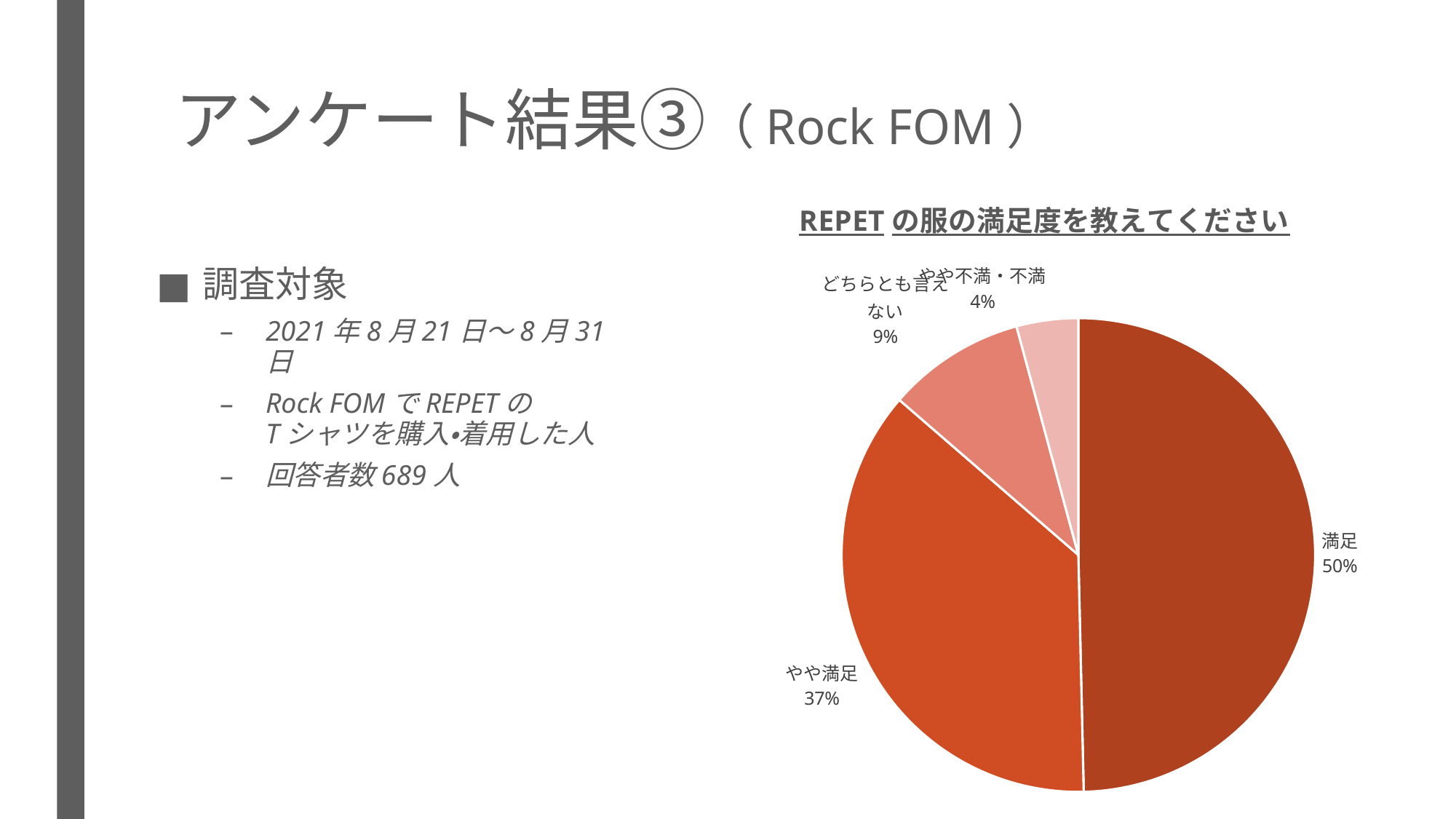
What share of the pie does やや不満・不満 represent? 4% How many slices does the pie chart have? 4 What share of the pie does どちらとも言えない represent? 9% What share of the pie does 満足 represent? 50% Which category has the smallest slice of the pie? やや不満・不満 What is the difference in percentage points between 満足 and やや満足? 13% What kind of chart is shown on the slide? Pie chart Which category has the largest slice of the pie? 満足 What is the combined share of 満足 and やや満足? 87% Which is larger, the slice for どちらとも言えない or the slice for やや不満・不満? どちらとも言えない What is the title of the chart? REPET の服の満足度を教えてください